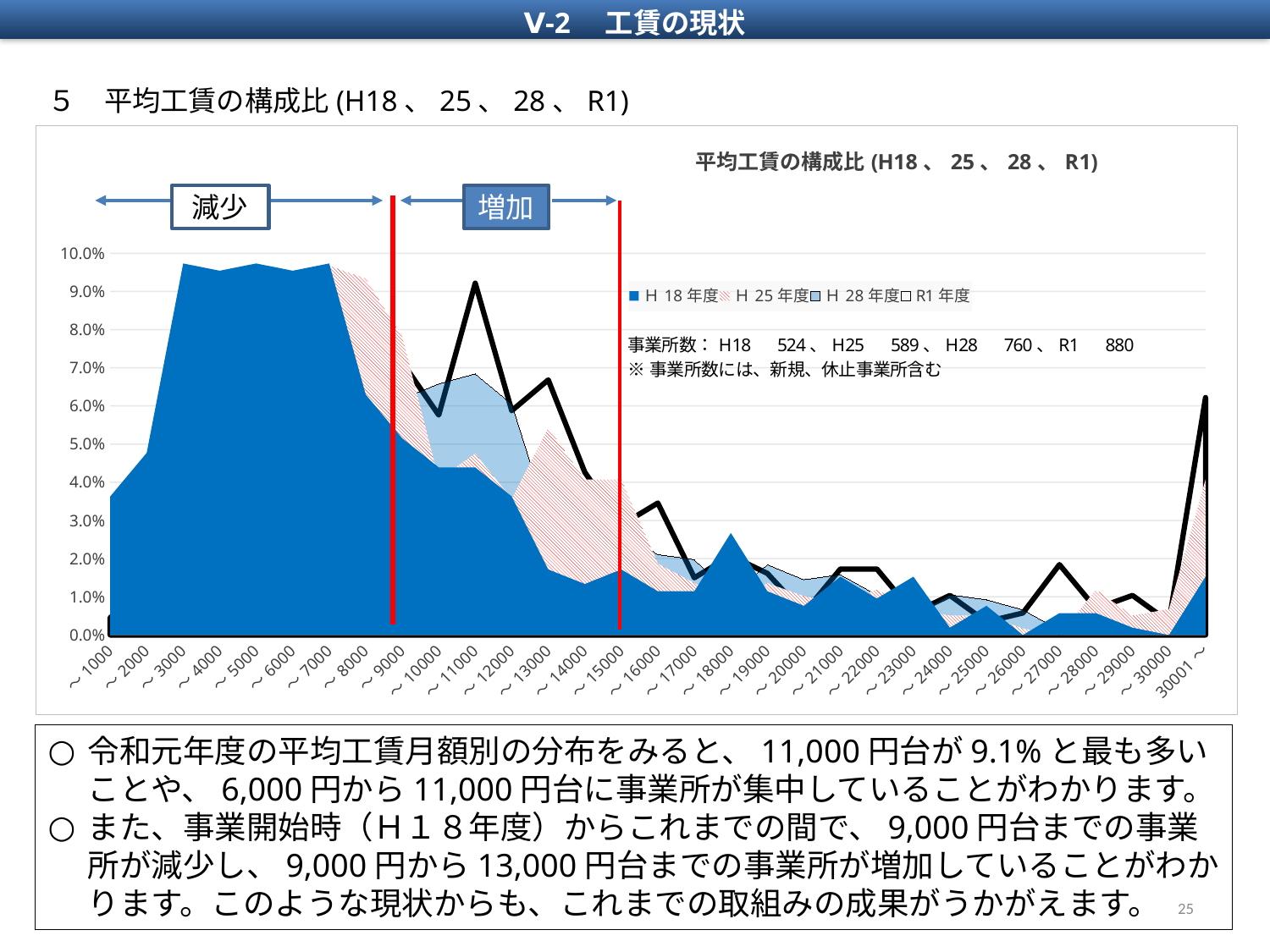
Is the R1年度 value for 30001～ greater or less than 5.0%? greater Which series are listed in the legend? H18年度, H25年度, H28年度, R1年度 How many series does the legend list? 4 At ～3000, which series has the larger value, H18年度 or R1年度? H18年度 Is the H18年度 value for ～3000 greater or less than 9.0%? greater Is the R1年度 value for ～11000 greater or less than 8.0%? greater What kind of chart is shown on the slide? Area chart What is the title of the chart? 平均工賃の構成比 (H18、25、28、R1) How many wage-band categories are shown on the x axis? 31 Does the H18年度 series rise or fall from ～7000 to ～10000? Fall For the R1年度 series, which wage band has the highest value? ～11000